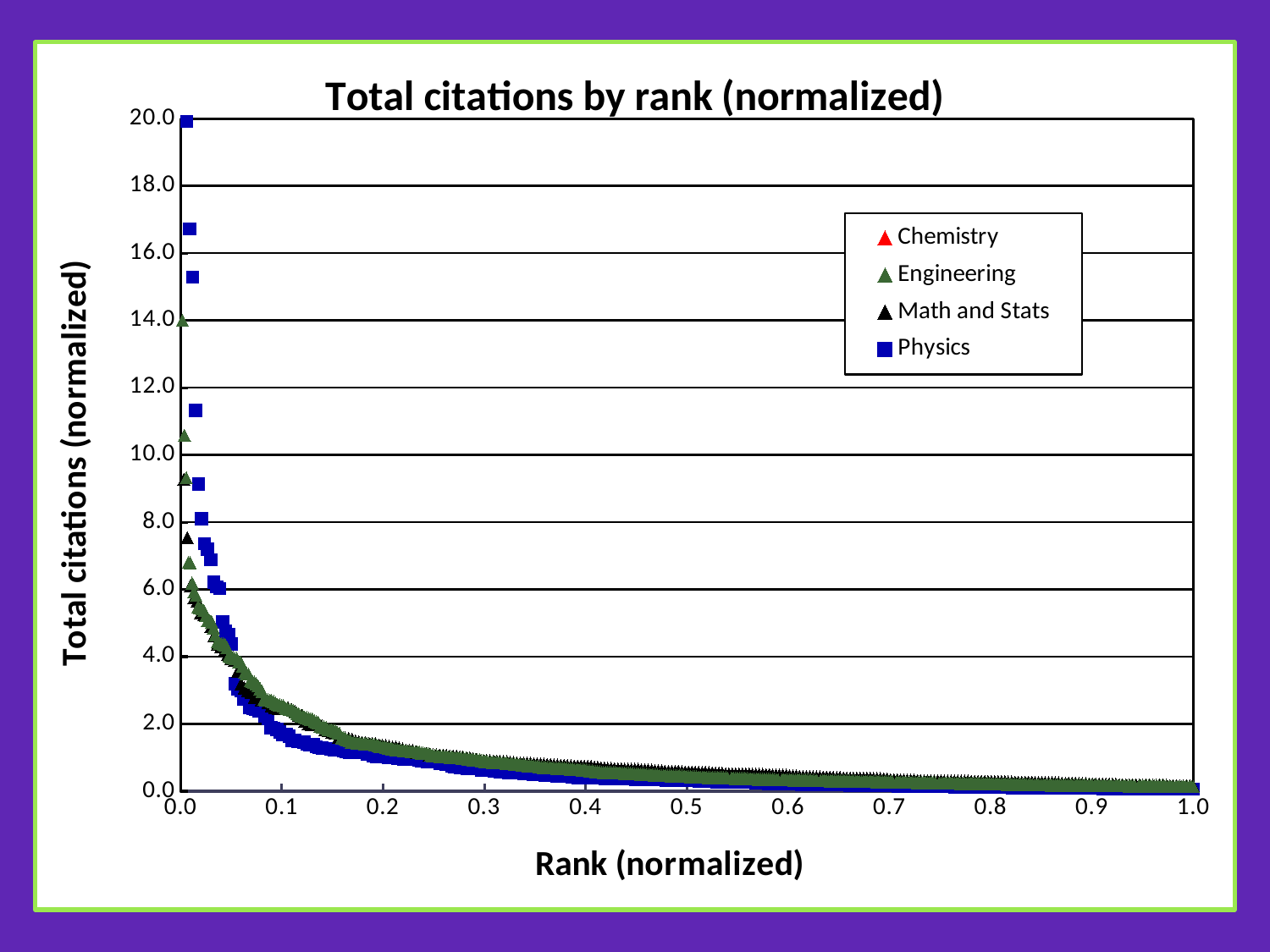
What is the label of the y axis? Total citations (normalized) Do the total citation values rise or fall as the normalized rank increases along the x axis? Fall Is the highest Math and Stats point greater or less than 10.0? less What is the maximum value shown on the y axis? 20.0 What is the label of the x axis? Rank (normalized) What kind of chart is shown on the slide? Scatter chart Which series has the single highest plotted point on the chart? Physics Is the highest Engineering point greater or less than 12.0? greater How many series does the legend list? 4 Is the highest Physics point greater or less than 18.0? greater